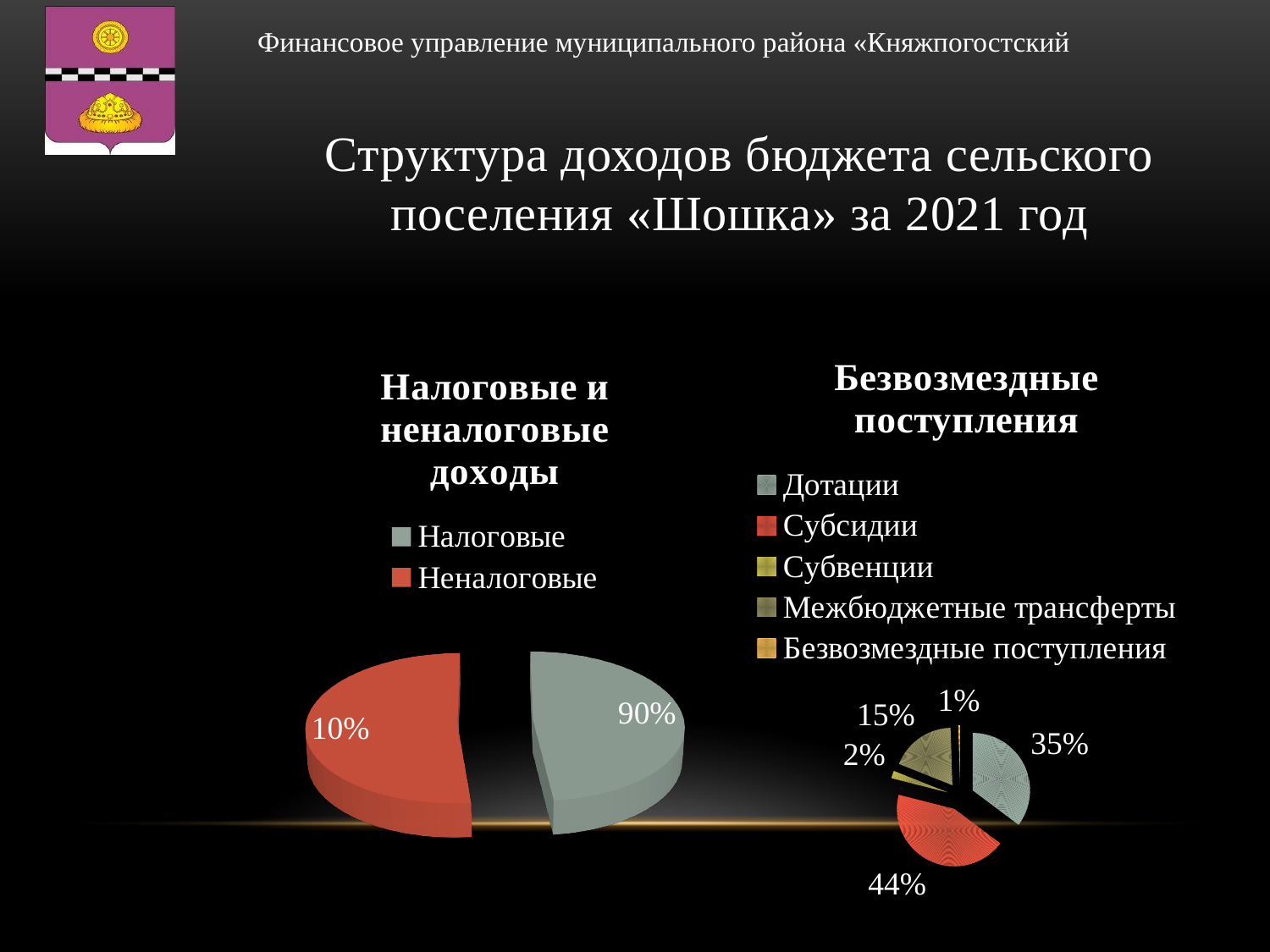
In the "Налоговые и неналоговые доходы" chart, which category has the larger share? Налоговые In the "Безвозмездные поступления" chart, which category has the smallest share? Безвозмездные поступления In the "Безвозмездные поступления" chart, what is the difference between the Субсидии and Дотации shares? 9% How many entries does the legend of the "Безвозмездные поступления" chart list? 5 In the "Налоговые и неналоговые доходы" chart, what share is Неналоговые? 10% In the "Налоговые и неналоговые доходы" chart, what is the difference between the Налоговые and Неналоговые shares? 80% In the "Безвозмездные поступления" chart, what share is Дотации? 35% What kind of chart is the "Налоговые и неналоговые доходы" chart? pie chart In the "Налоговые и неналоговые доходы" chart, what share is Налоговые? 90% In the "Безвозмездные поступления" chart, what share is Межбюджетные трансферты? 15% In the "Безвозмездные поступления" chart, what share is Субсидии? 44% In the "Безвозмездные поступления" chart, which category has the largest share? Субсидии